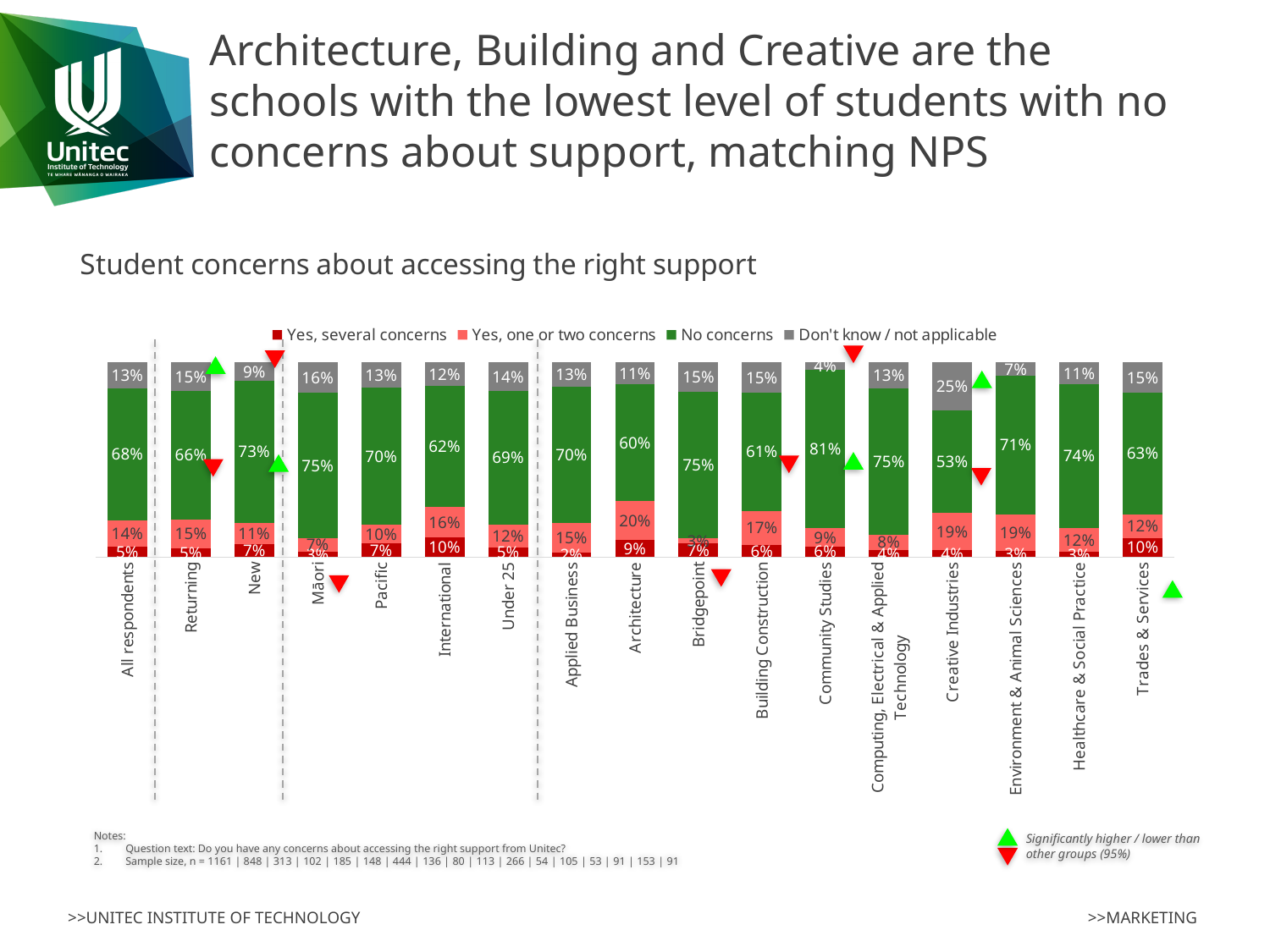
What type of chart is shown on the slide? Stacked bar chart Which has a larger 'No concerns' value, International or Healthcare & Social Practice? Healthcare & Social Practice What is the 'Yes, several concerns' value for International students? 10% Which category has the lowest 'No concerns' value? Creative Industries What is the 'Don't know / not applicable' value for Creative Industries? 25% What is the 'Yes, one or two concerns' value for Architecture? 20% How many series does the legend list? 4 What is the title of the chart? Student concerns about accessing the right support Which category has the highest 'No concerns' value? Community Studies Which category has the highest 'Don't know / not applicable' value? Creative Industries What is the difference between the 'No concerns' values for New and Returning students? 7% What is the 'No concerns' value for All respondents? 68%